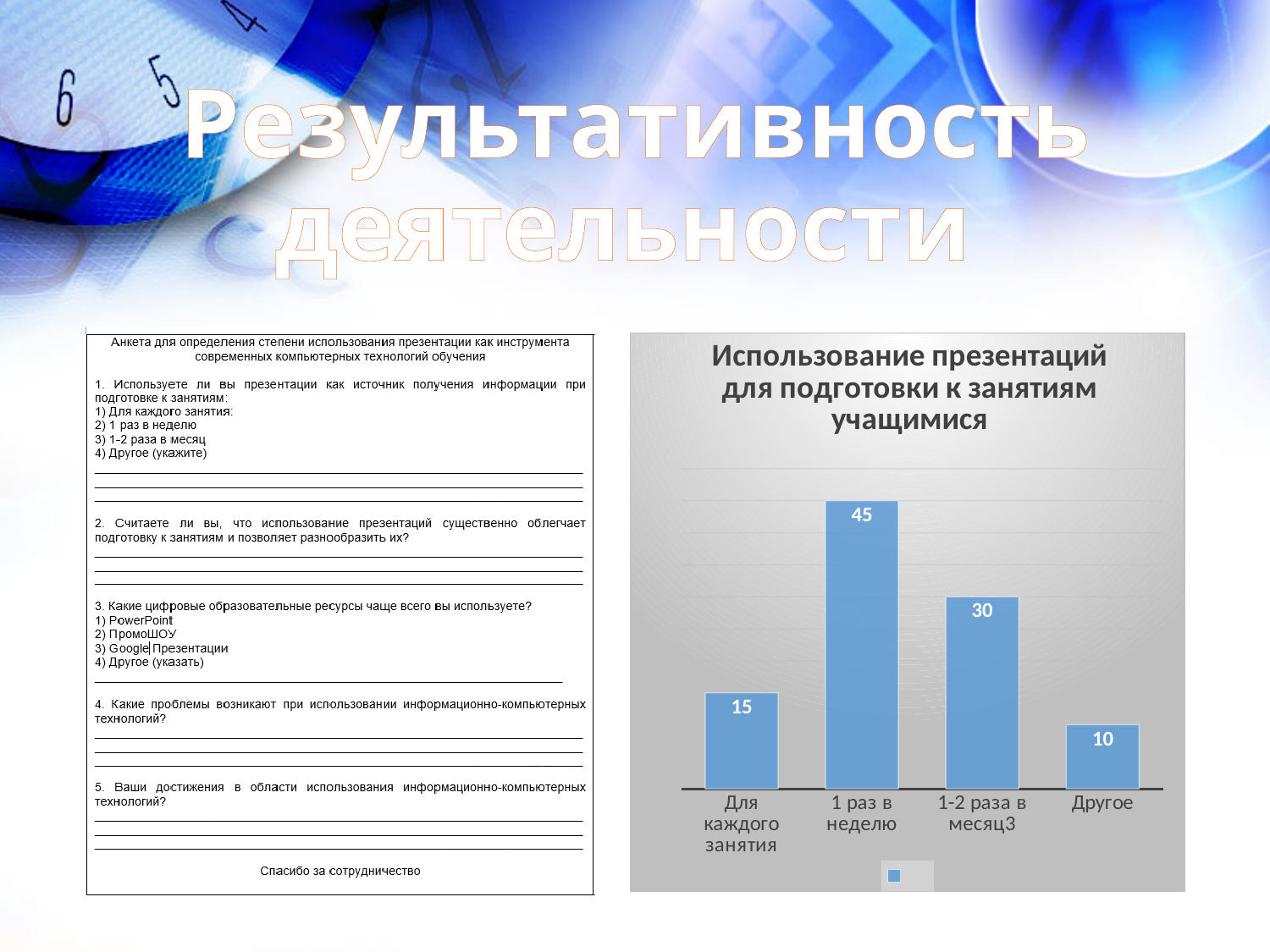
What is the title of the chart? Использование презентаций для подготовки к занятиям учащимися What type of chart is shown on the slide? bar chart Which category has the lowest value? Другое What is the difference between the values for "Для каждого занятия" and "Другое"? 5 How many categories are shown on the x axis of the chart? 4 What is the value for "1 раз в неделю"? 45 Which is larger, the value for "Для каждого занятия" or the value for "Другое"? Для каждого занятия What is the value for "Другое"? 10 What is the value for "Для каждого занятия"? 15 What is the difference between the values for "1 раз в неделю" and "1-2 раза в месяц"? 15 Which category has the highest value? 1 раз в неделю What is the value for "1-2 раза в месяц"? 30